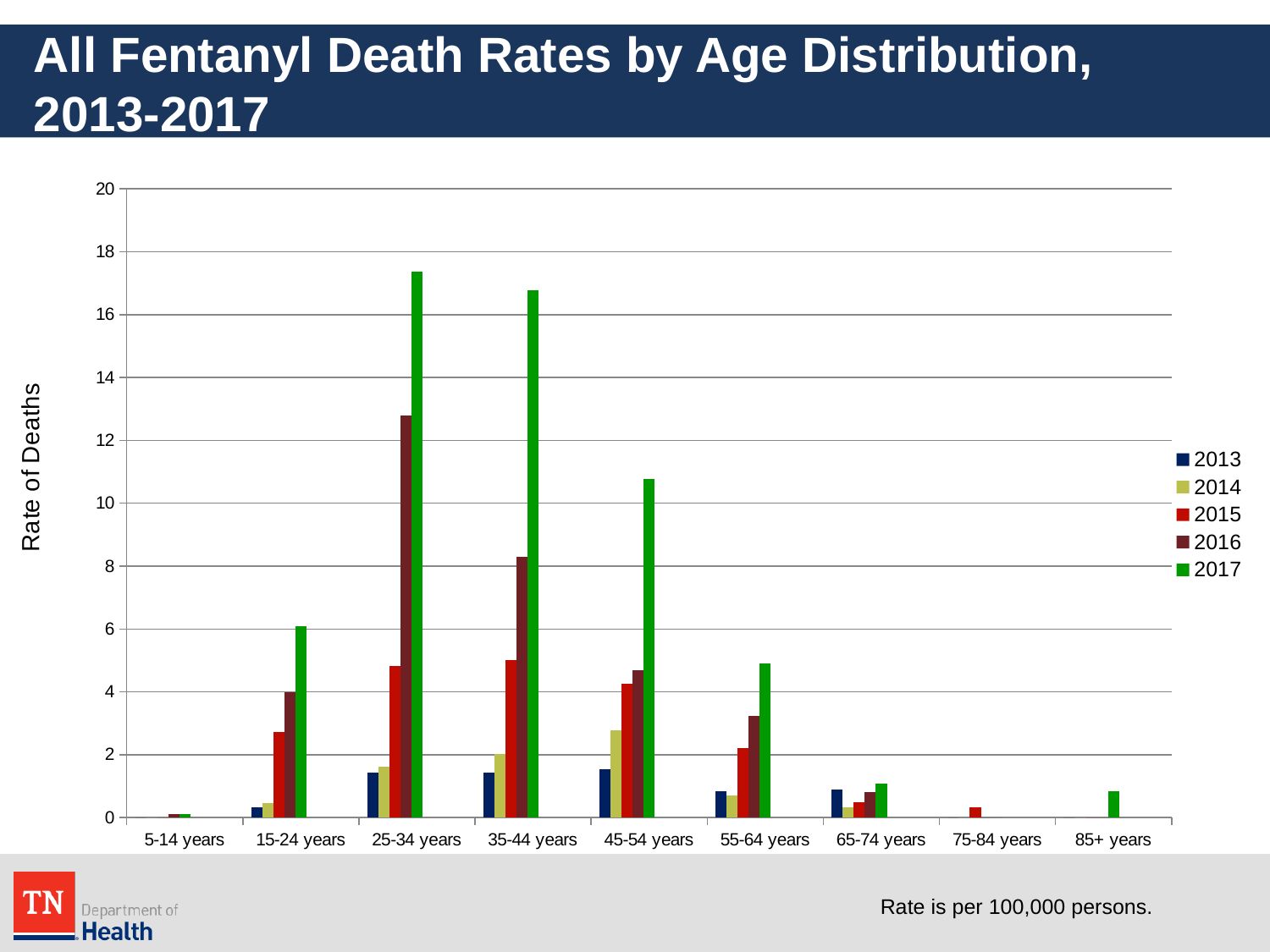
Is the 2016 value for 25-34 years greater or less than 12? greater For 2017, which age group has the larger value, 15-24 years or 55-64 years? 15-24 years For 35-44 years, which is larger, the 2016 value or the 2017 value? 2017 What kind of chart is shown on the slide? Bar chart Which age group has the highest 2016 fentanyl death rate? 25-34 years Is the 2017 value for 45-54 years greater or less than 10? greater How many series does the legend list? 5 For 25-34 years, do the rates rise or fall from 2013 to 2017? Rise Which age group has the highest 2017 fentanyl death rate? 25-34 years Is the 2017 value for 55-64 years greater or less than 4? greater How many age groups are shown on the x axis? 9